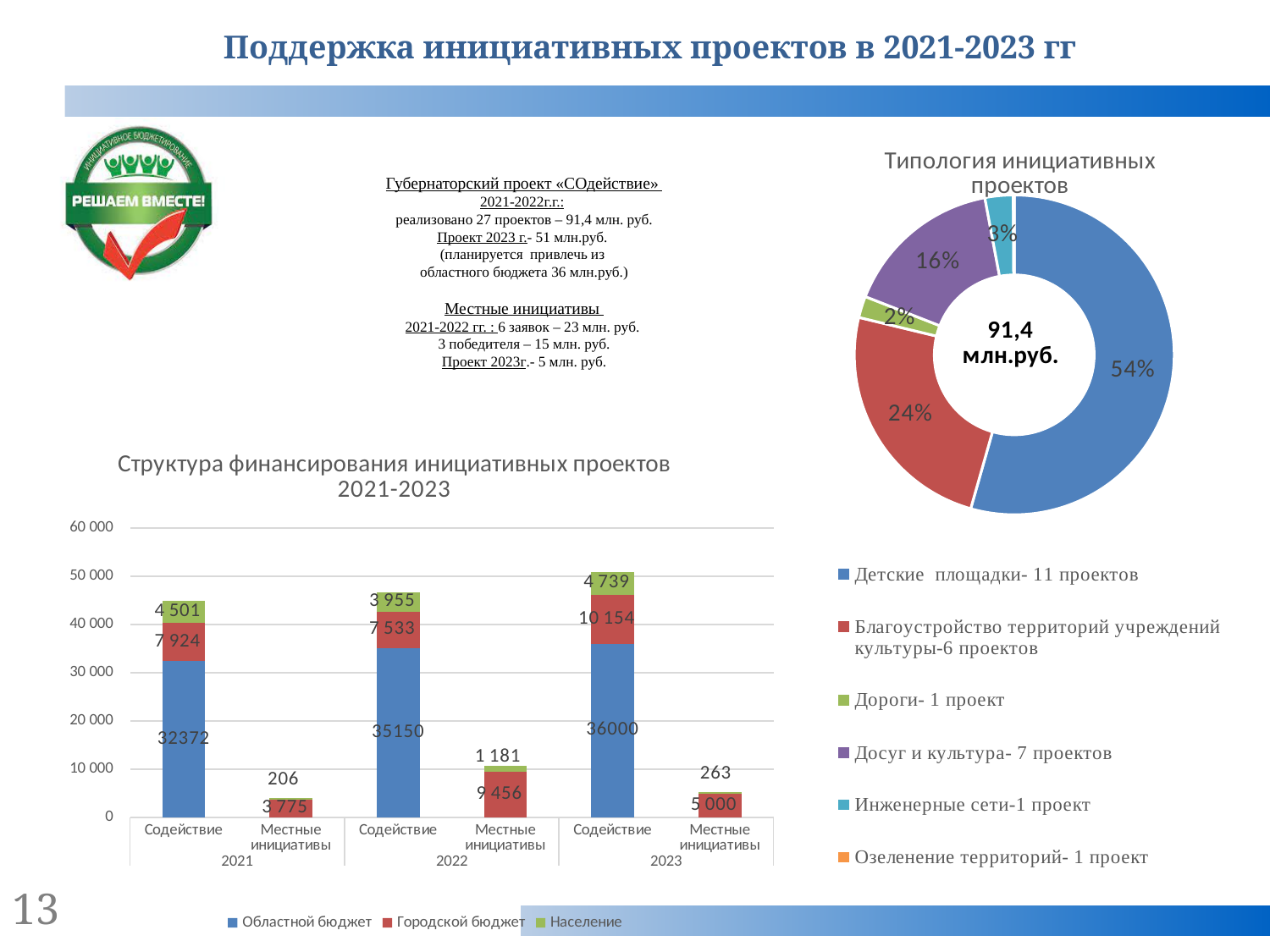
In the bar chart 'Структура финансирования инициативных проектов 2021-2023', does the Областной бюджет value for Содействие rise or fall from 2021 to 2023? rises What value is printed in the centre of the doughnut chart 'Типология инициативных проектов'? 91,4 млн.руб. In the doughnut chart 'Типология инициативных проектов', what share is shown for Детские площадки? 54% In the doughnut chart 'Типология инициативных проектов', which category has the largest slice? Детские площадки How many categories does the legend of the doughnut chart 'Типология инициативных проектов' list? 6 In the bar chart 'Структура финансирования инициативных проектов 2021-2023', what is the Городской бюджет value for Содействие in 2021? 7 924 In the doughnut chart 'Типология инициативных проектов', what share is shown for Досуг и культура? 16% How many series does the legend of the bar chart 'Структура финансирования инициативных проектов 2021-2023' list? 3 What kind of chart is 'Структура финансирования инициативных проектов 2021-2023'? stacked bar chart In the bar chart 'Структура финансирования инициативных проектов 2021-2023', what is the difference between the Областной бюджет values for Содействие in 2023 and 2021? 3628 In the bar chart 'Структура финансирования инициативных проектов 2021-2023', what is the Население value for Содействие in 2022? 3 955 In the bar chart 'Структура финансирования инициативных проектов 2021-2023', what is the Областной бюджет value for Содействие in 2023? 36000